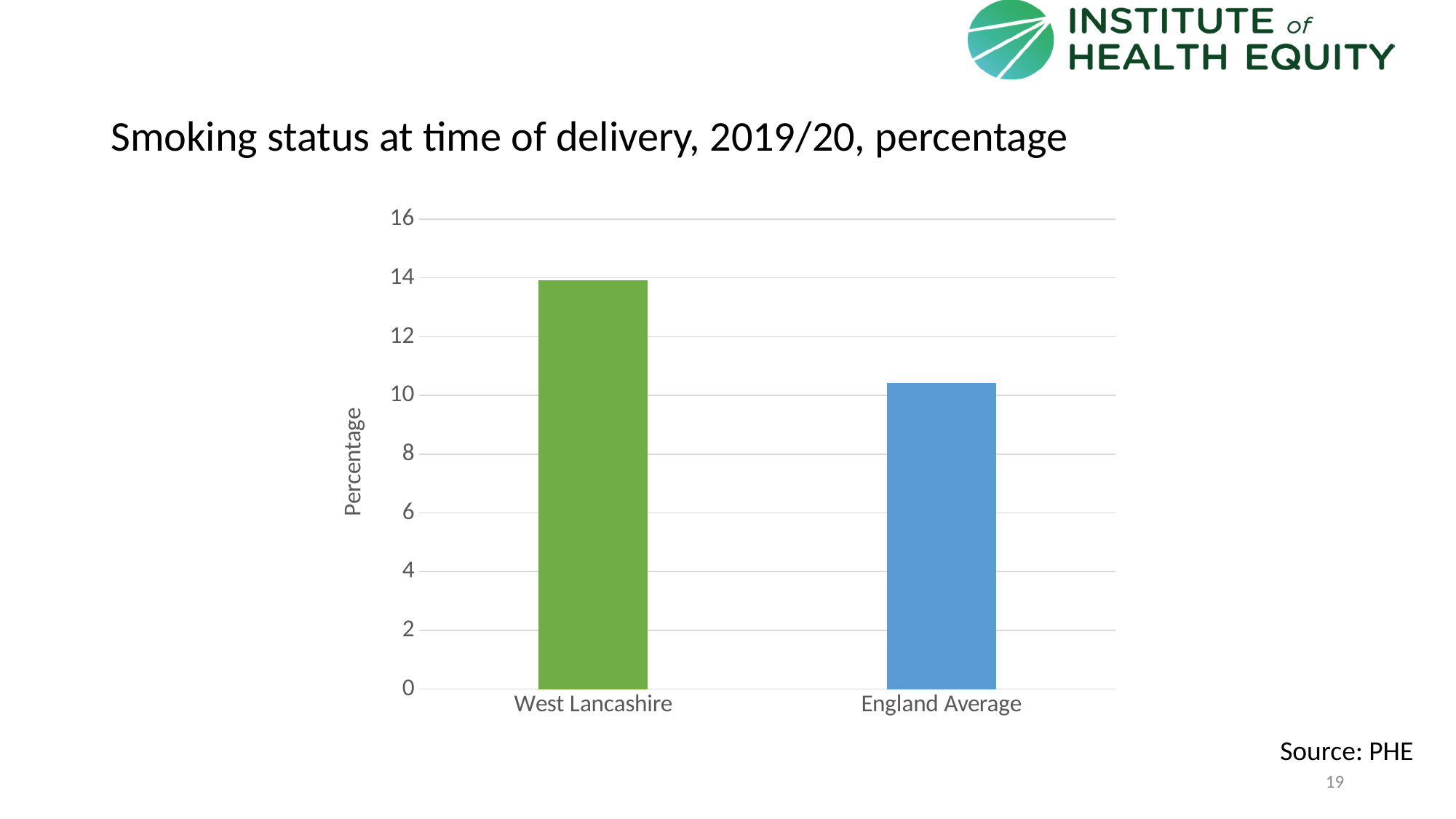
Which category has the lowest value? England Average What kind of chart is shown on the slide? bar chart Which category has the highest value? West Lancashire How many categories are plotted on the chart? 2 Is the value for West Lancashire greater or less than 12? greater Is the value for England Average greater or less than 10? greater What is the label on the vertical axis? Percentage Is the value for England Average greater or less than 12? less What is the title of the chart? Smoking status at time of delivery, 2019/20, percentage Which is larger, the value for West Lancashire or the value for England Average? West Lancashire